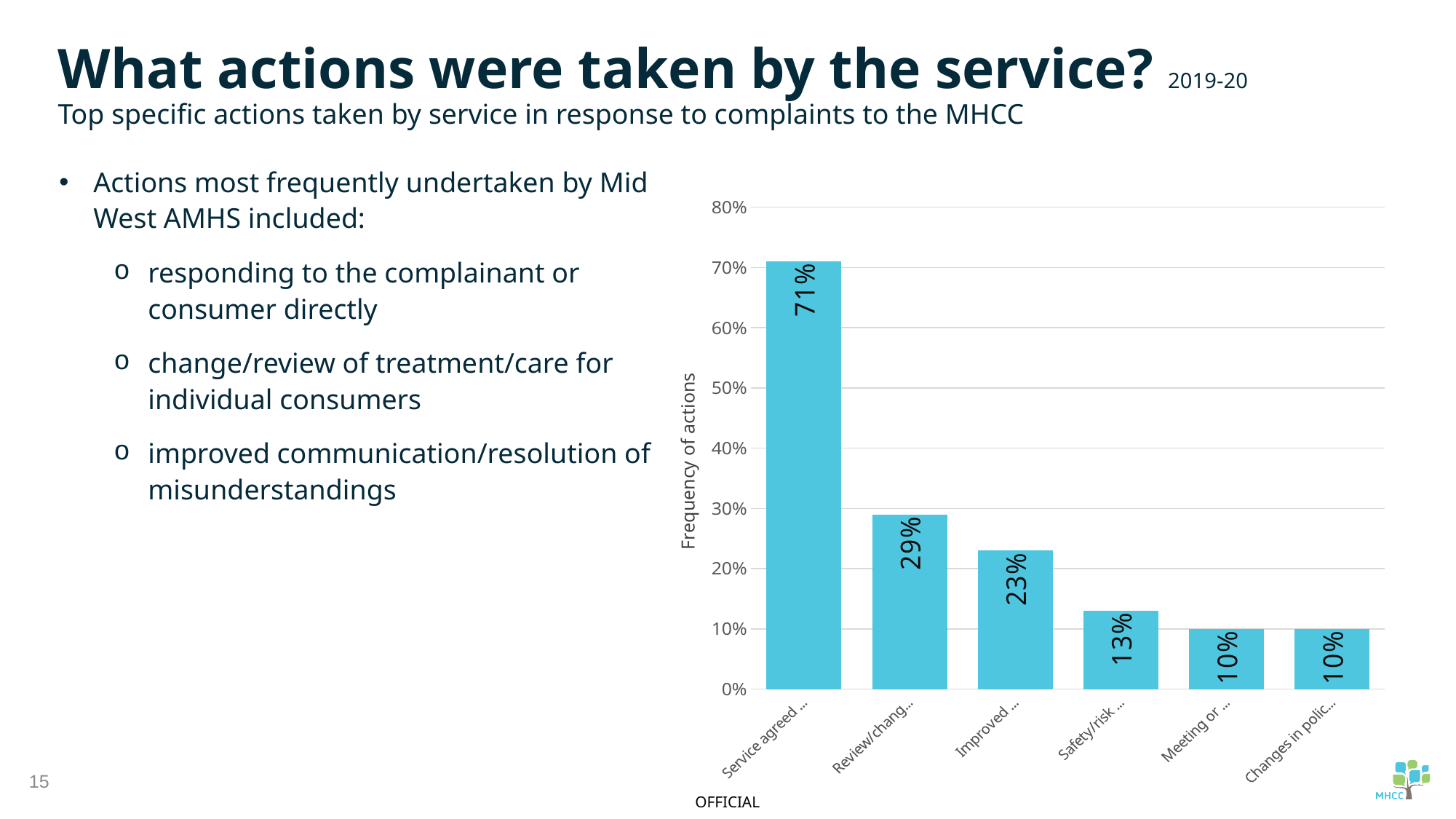
What is the value of the bar labelled "Review/chang..."? 29% Do the bar values rise or fall from left to right along the x axis? fall What is the value of the bar labelled "Safety/risk ..."? 13% Is the value for "Review/chang..." greater or less than 20%? greater Which bar has the highest value? Service agreed ... What is the value of the last bar, labelled "Changes in polic..."? 10% What is the value of the first bar, labelled "Service agreed ..."? 71% What type of chart is shown on the slide? bar chart Which is larger: the value for "Improved ..." or the value for "Safety/risk ..."? Improved ... What is the label of the vertical axis? Frequency of actions What is the difference between the first bar ("Service agreed ...") and the second bar ("Review/chang...")? 42% How many bars are plotted in the chart? 6